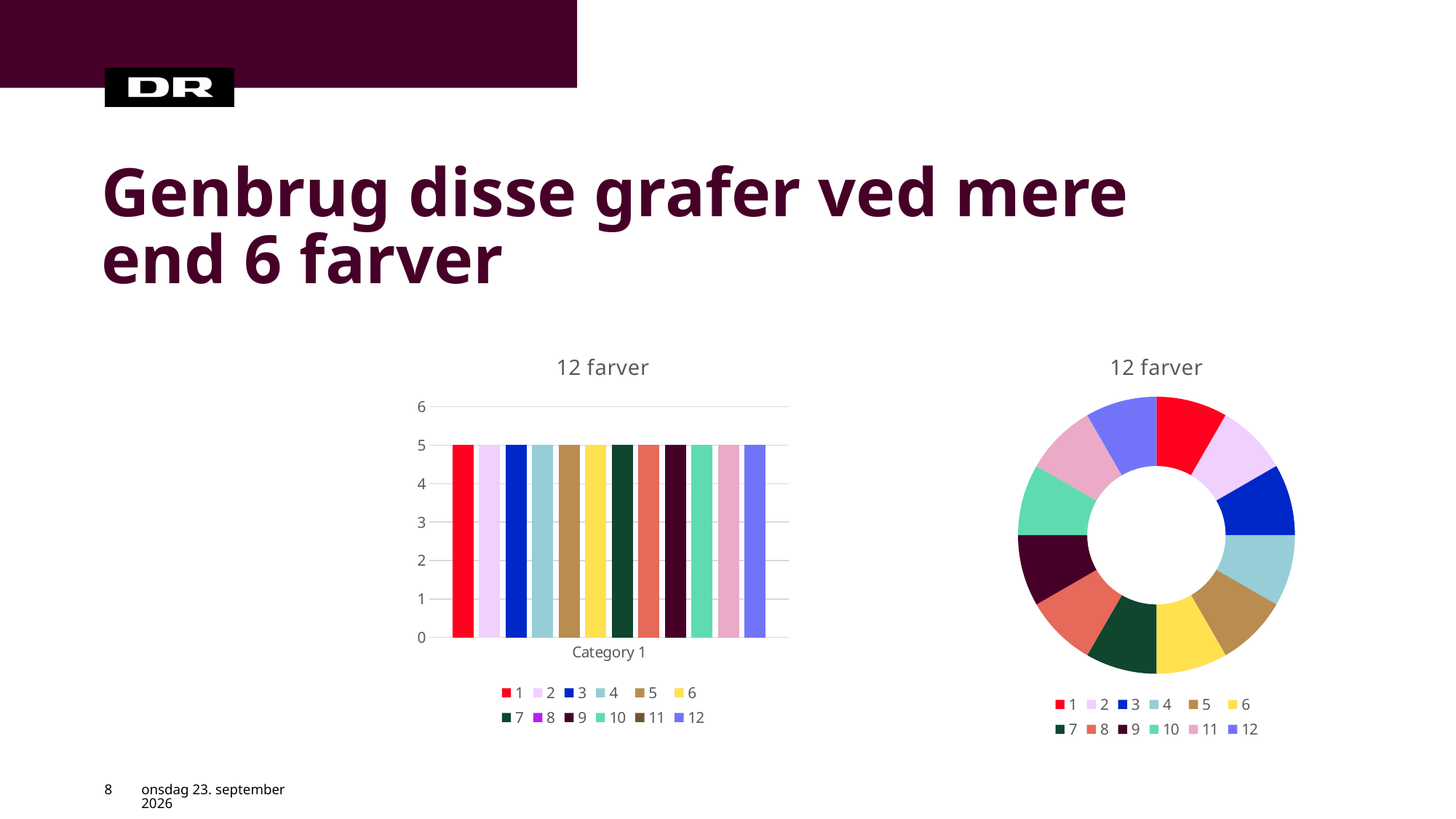
In the doughnut chart on the right, how many series does the legend list? 12 In the bar chart on the left, how many series does the legend list? 12 What kind of chart is the chart on the right of the slide? doughnut chart What is the title of the bar chart on the left? 12 farver In the bar chart on the left, is the value for series 7 greater or less than 4? greater In the bar chart on the left, is the value for series 3 greater or less than 6? less In the bar chart on the left, how many categories are shown on the x axis? 1 In the bar chart on the left, what is the value for series 12 in Category 1? 5 What kind of chart is the chart on the left of the slide? bar chart In the bar chart on the left, what is the value for series 1 in Category 1? 5 In the bar chart on the left, what is the value for series 6 in Category 1? 5 In the bar chart on the left, what is the label of the category on the x axis? Category 1